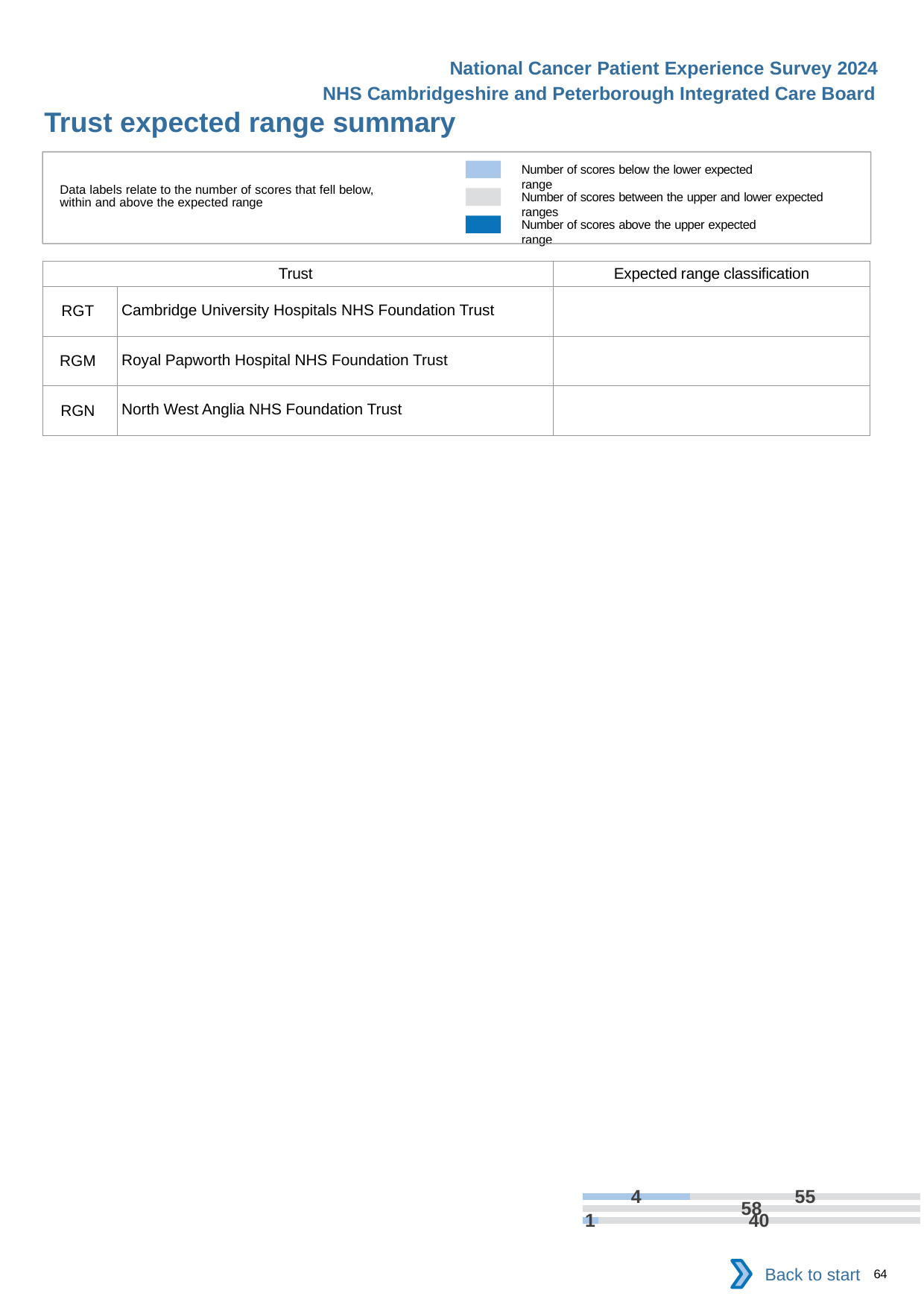
In the chart at the bottom right, what is the value of the grey segment of the bottom bar? 40 In the chart at the bottom right, what is the value of the light blue segment of the top bar? 4 In the chart at the bottom right, what is the value labelled on the middle bar? 58 According to the legend, which colour represents the number of scores above the upper expected range? Dark blue In the chart at the bottom right, what is the total of the bottom bar's labelled segments? 41 In the chart at the bottom right, what is the difference between the grey segment of the top bar and the grey segment of the bottom bar? 15 In the chart at the bottom right, what is the value of the grey segment of the top bar? 55 What kind of chart is shown at the bottom right of the slide? Stacked bar chart How many bars does the chart at the bottom right of the slide contain? 3 In the chart at the bottom right, what is the total of the top bar's labelled segments? 59 In the chart at the bottom right, what is the value of the light blue segment of the bottom bar? 1 In the chart at the bottom right, which bar has the largest grey segment value? Middle bar